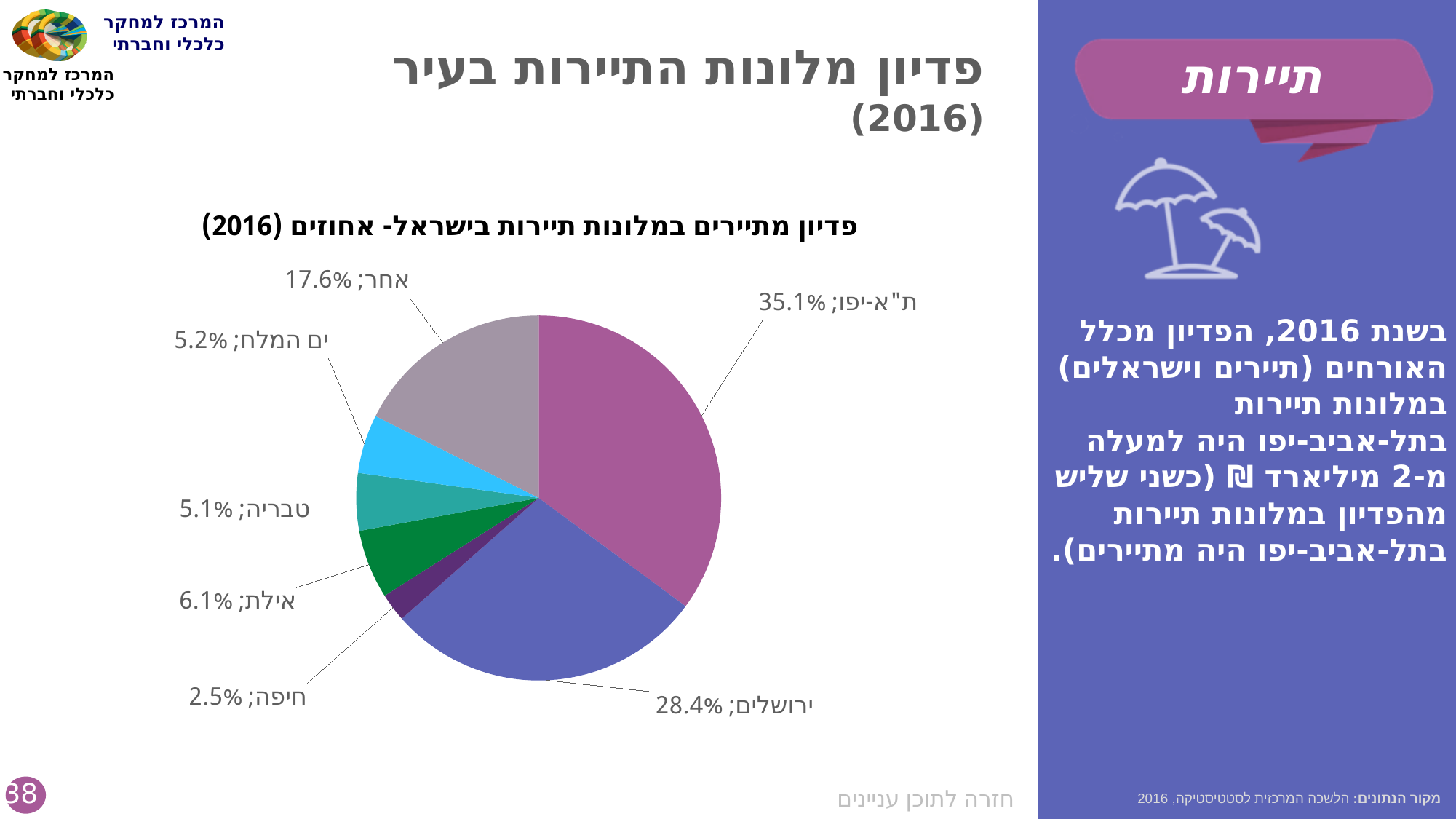
Which is larger, the share for אילת or the share for טבריה? אילת What share of the pie does ת"א-יפו (Tel Aviv-Yafo) hold? 35.1% What percentage is shown for חיפה (Haifa)? 2.5% Which category has the largest slice of the pie? ת"א-יפו How many slices does the pie chart have? 7 What is the combined share of ים המלח and טבריה? 10.3% Which category has the smallest slice of the pie? חיפה What is the difference between the shares of ת"א-יפו and ירושלים? 6.7% What is the value shown for ירושלים (Jerusalem)? 28.4% What is the title of the chart? פדיון מתיירים במלונות תיירות בישראל- אחוזים (2016) What is the value for אילת (Eilat)? 6.1% What type of chart is shown on the slide? Pie chart